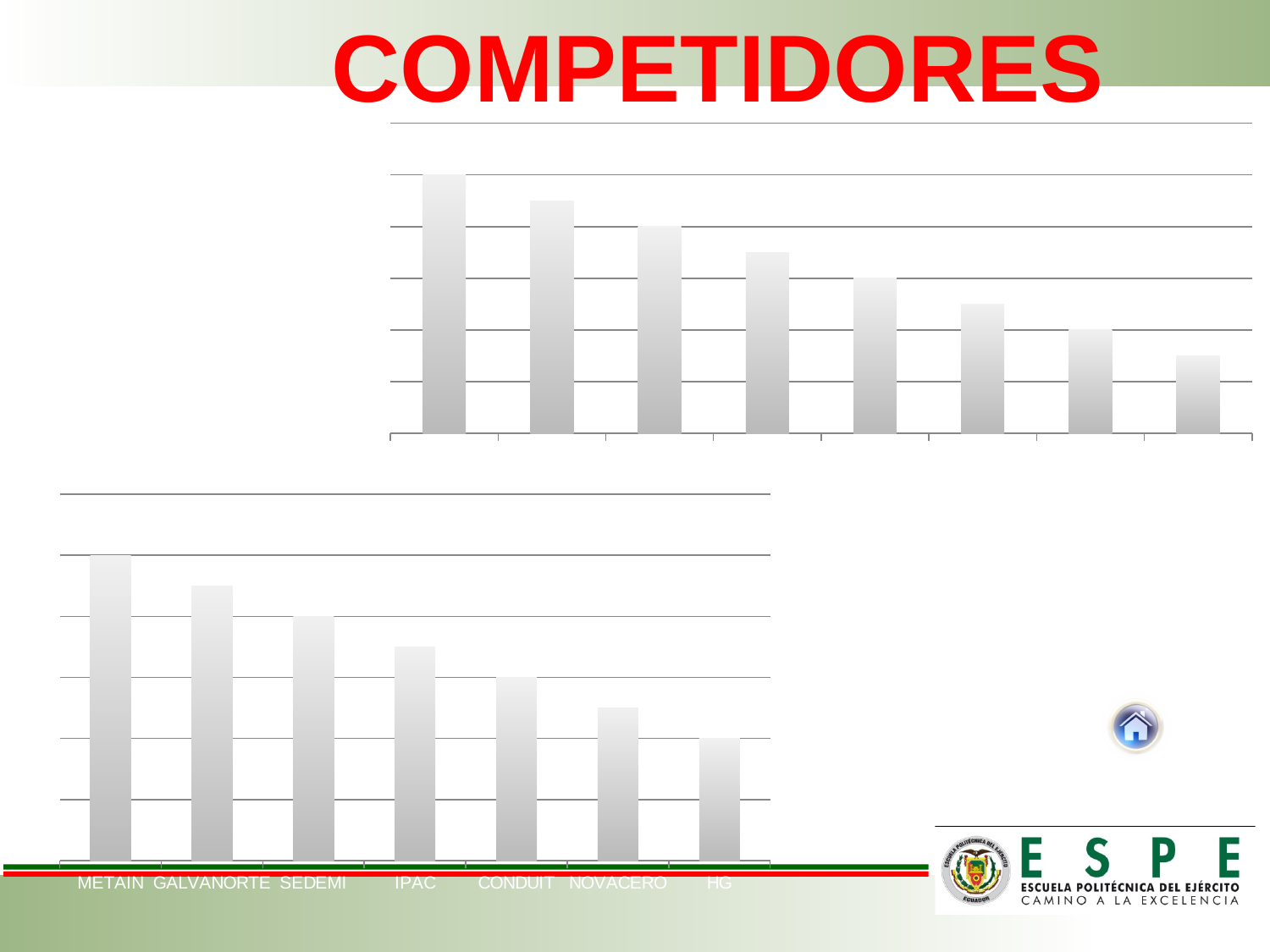
How many categories does the bottom chart show? 7 What kind of chart is the top chart on the slide? bar chart In the bottom chart, do the bar values rise or fall from left to right? fall In the bottom chart, which is larger, the value for NOVACERO or the value for SEDEMI? SEDEMI In the top chart, do the bar values rise or fall from left to right? fall What is the title of the slide containing the charts? COMPETIDORES In the bottom chart, which is larger, the value for GALVANORTE or the value for IPAC? GALVANORTE How many bars does the top chart show? 8 In the bottom chart, which category has the highest bar? METAIN What kind of chart is the bottom chart on the slide? bar chart In the bottom chart, which category has the lowest bar? HG In the bottom chart, which category is listed immediately after IPAC on the x axis? CONDUIT